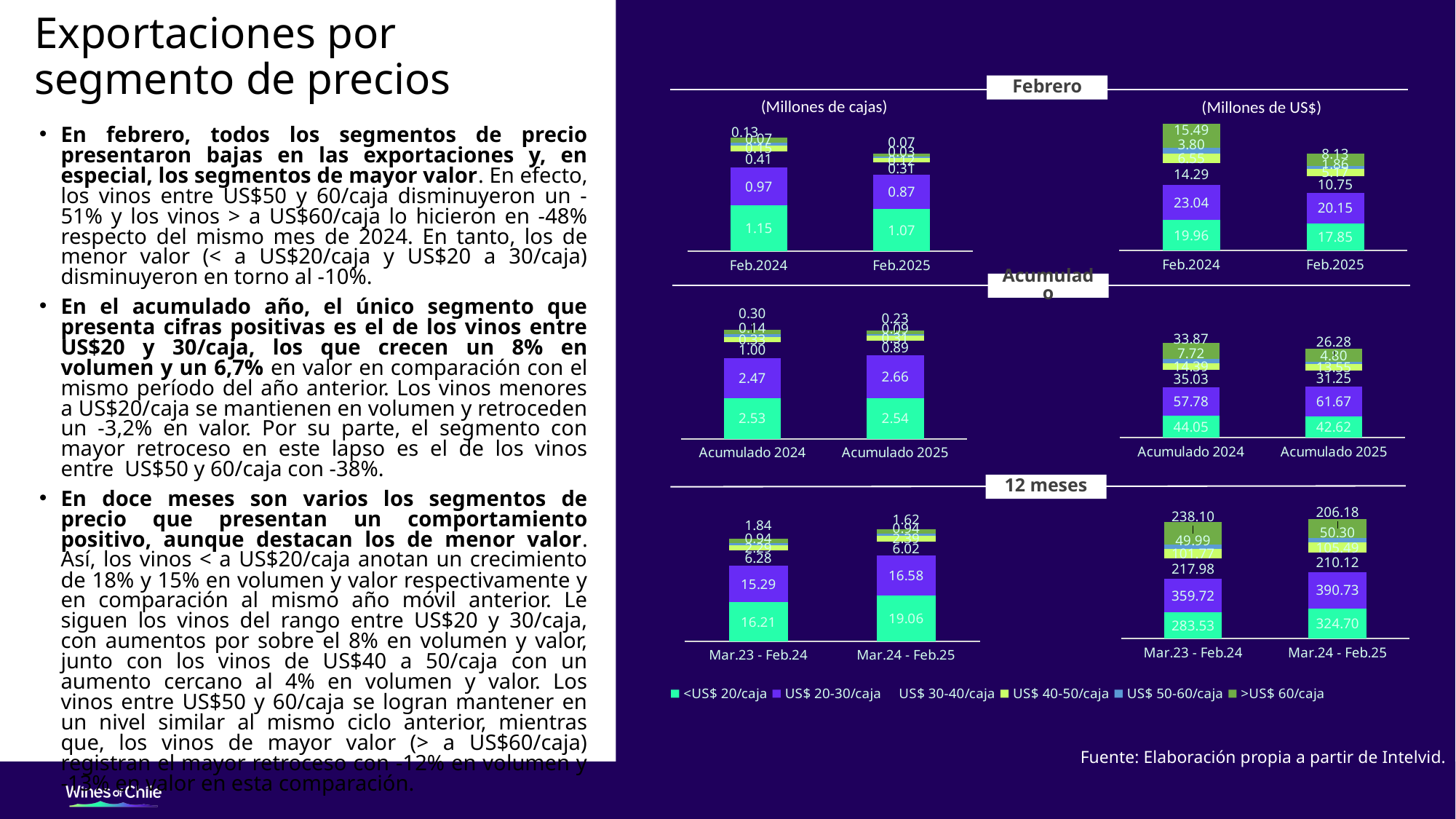
In the 12 meses chart in millions of US$, what is the value of the US$ 20-30/caja segment for Mar.24 - Feb.25? 390.73 In the Febrero chart in millions of US$, what is the value of the US$ 20-30/caja segment for Feb.2025? 20.15 In the 12 meses chart in millions of US$, what is the difference between the <US$ 20/caja values for Mar.24 - Feb.25 and Mar.23 - Feb.24? 41.17 In the Febrero chart in millions of boxes (Millones de cajas), what is the value of the <US$ 20/caja segment for Feb.2024? 1.15 In the 12 meses chart in millions of boxes, what is the value of the <US$ 20/caja segment for Mar.24 - Feb.25? 19.06 In the Febrero chart in millions of US$, what is the value of the >US$ 60/caja segment for Feb.2024? 15.49 What kind of chart is used in the Febrero section in millions of boxes? Stacked bar chart In the Acumulado chart in millions of boxes, what is the value of the US$ 20-30/caja segment for Acumulado 2025? 2.66 How many bars are shown in the 12 meses chart in millions of US$? 2 How many series does the legend list for the charts? 6 In the Febrero chart in millions of US$, which is larger for Feb.2024: the <US$ 20/caja segment or the US$ 20-30/caja segment? US$ 20-30/caja In the Acumulado chart in millions of US$, what is the value of the US$ 20-30/caja segment for Acumulado 2024? 57.78